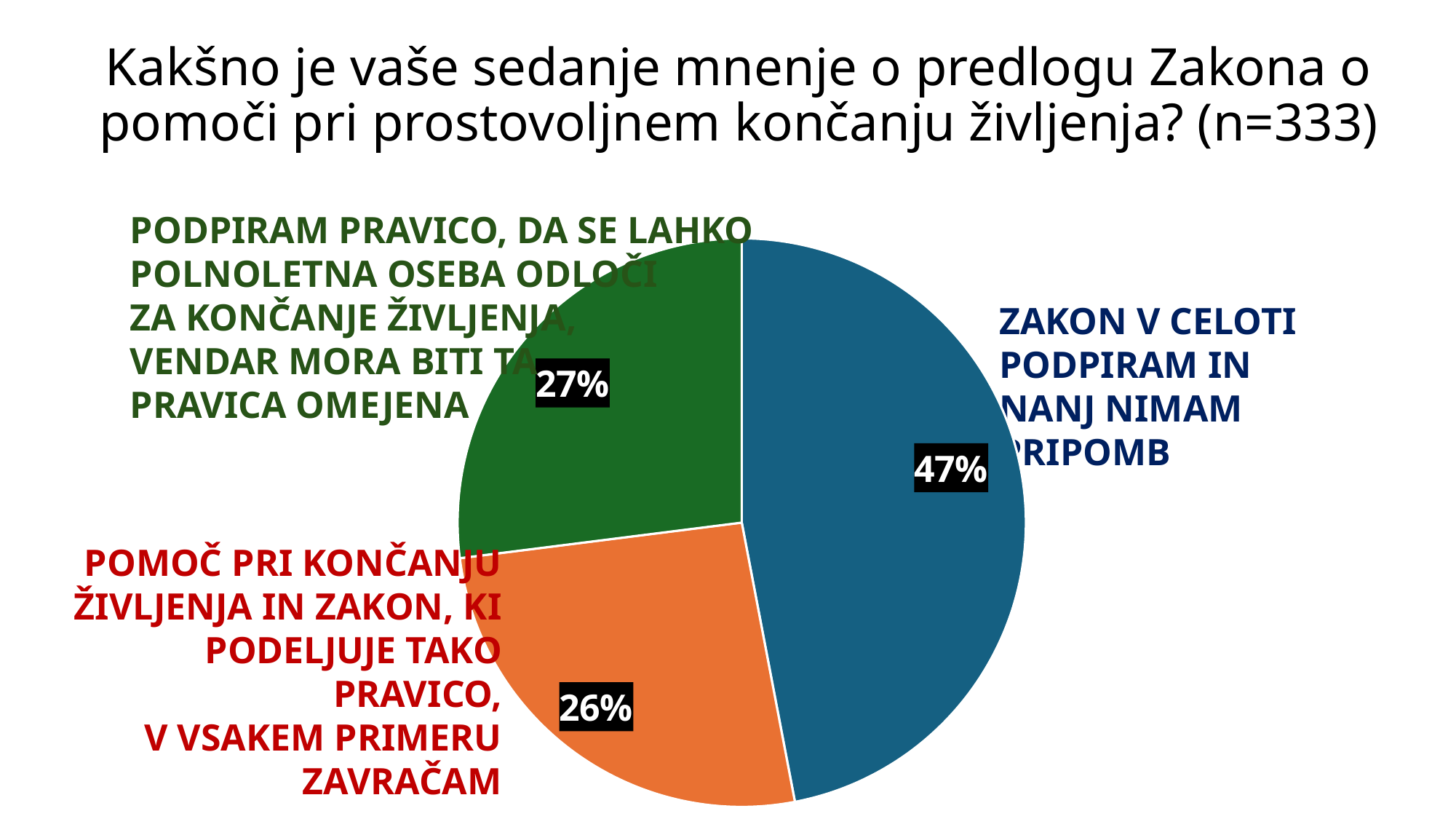
What is the combined share of the two slices that express some support for the law (47% and 27%)? 74% Which response has the largest share of the pie? Zakon v celoti podpiram in nanj nimam pripomb What colour is the slice labelled 47%? blue How many slices does the pie chart have? 3 What sample size (n) is given in the chart title? 333 What share of respondents chose "Zakon v celoti podpiram in nanj nimam pripomb"? 47% What share of respondents chose "Podpiram pravico, da se lahko polnoletna oseba odloči za končanje življenja, vendar mora biti ta pravica omejena"? 27% Which is larger: the share for "Zakon v celoti podpiram in nanj nimam pripomb" or the share for "Pomoč pri končanju življenja ... v vsakem primeru zavračam"? Zakon v celoti podpiram in nanj nimam pripomb What is the difference in percentage points between the "Zakon v celoti podpiram" slice and the "v vsakem primeru zavračam" slice? 21 What share of respondents chose "Pomoč pri končanju življenja in zakon, ki podeljuje tako pravico, v vsakem primeru zavračam"? 26% Which response has the smallest share of the pie? Pomoč pri končanju življenja in zakon, ki podeljuje tako pravico, v vsakem primeru zavračam What kind of chart is shown on the slide? pie chart